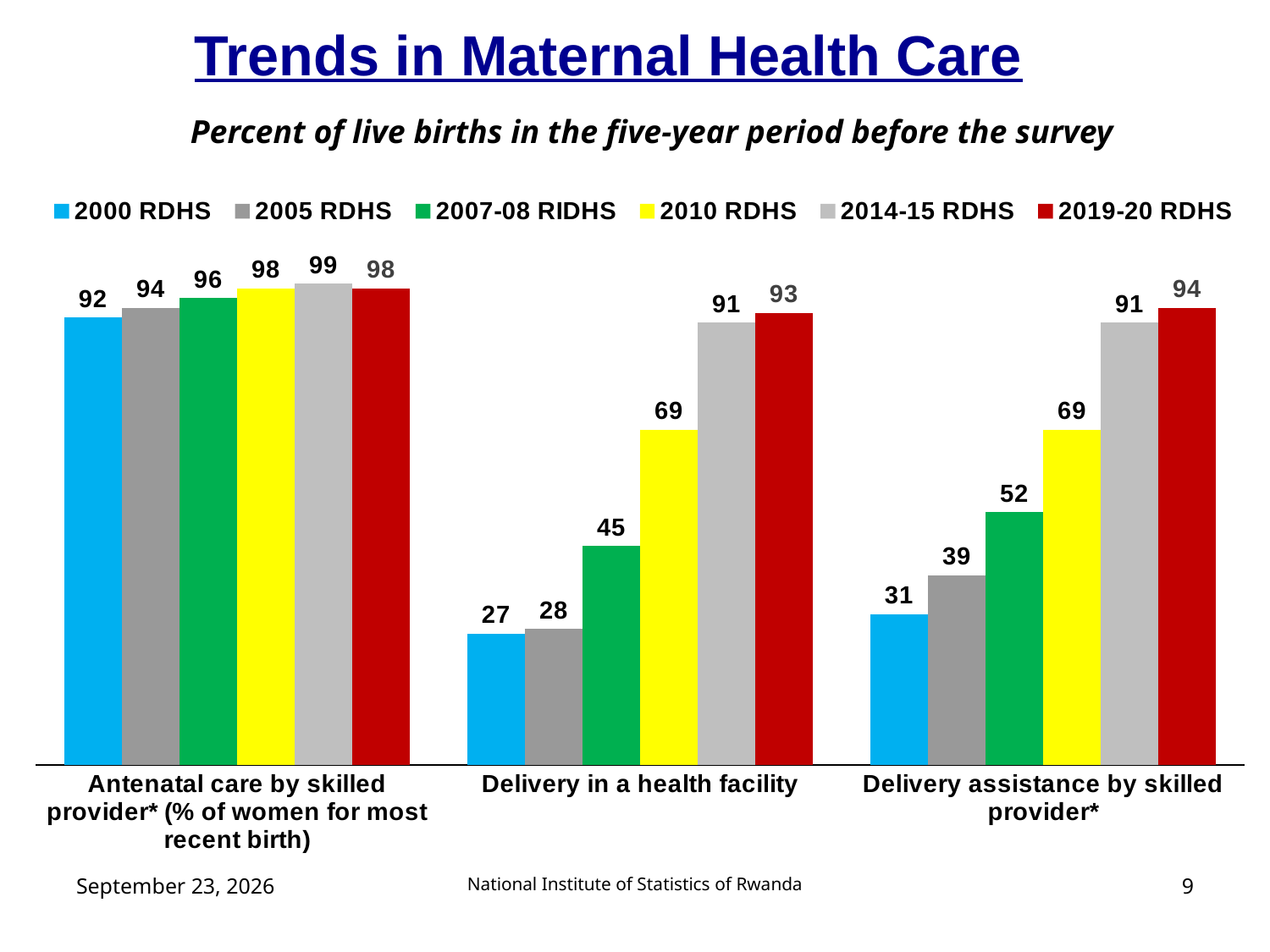
What kind of chart is shown on the slide? Bar chart How many categories are shown on the x axis? 3 Which is larger for the 2010 RDHS: Delivery in a health facility or Antenatal care by skilled provider? Antenatal care by skilled provider What is the value for Delivery in a health facility in the 2000 RDHS series? 27 Which survey has the highest value for Delivery in a health facility? 2019-20 RDHS Do the values for Delivery in a health facility rise or fall from the 2000 RDHS to the 2019-20 RDHS? Rise How many series does the legend list? 6 Which survey has the lowest value for Delivery assistance by skilled provider? 2000 RDHS What is the difference between the 2019-20 RDHS and 2000 RDHS values for Delivery in a health facility? 66 What is the difference between the 2010 RDHS and 2005 RDHS values for Delivery assistance by skilled provider? 30 What is the value for Delivery assistance by skilled provider in the 2007-08 RIDHS series? 52 What is the value for Antenatal care by skilled provider in the 2014-15 RDHS series? 99